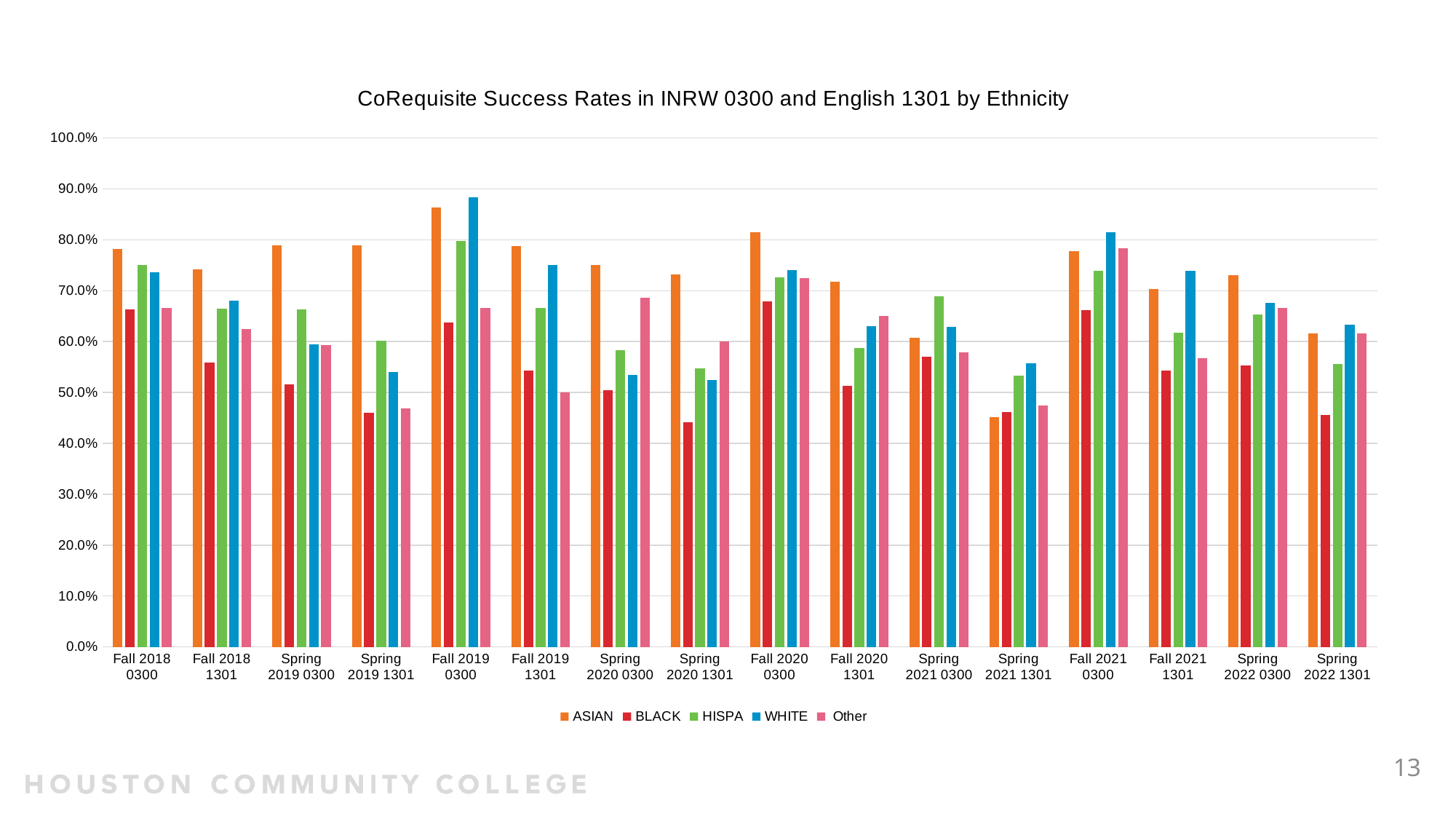
In Fall 2018 1301, which is larger: the BLACK success rate or the WHITE success rate? WHITE Which ethnicity has the lowest success rate in Fall 2019 0300? BLACK Is the WHITE success rate for Fall 2021 0300 greater or less than 80.0%? greater What kind of chart is shown on the slide? Bar chart Which ethnicity has the lowest success rate in Spring 2020 1301? BLACK In Spring 2021 0300, which is larger: the ASIAN success rate or the HISPA success rate? HISPA What is the title of the chart? CoRequisite Success Rates in INRW 0300 and English 1301 by Ethnicity Is the BLACK success rate for Spring 2019 1301 greater or less than 50.0%? less How many series does the legend list? 5 Is the ASIAN success rate for Fall 2018 0300 greater or less than 70.0%? greater Which ethnicity has the highest success rate in Fall 2020 0300? ASIAN How many term/course categories are shown on the x axis? 16